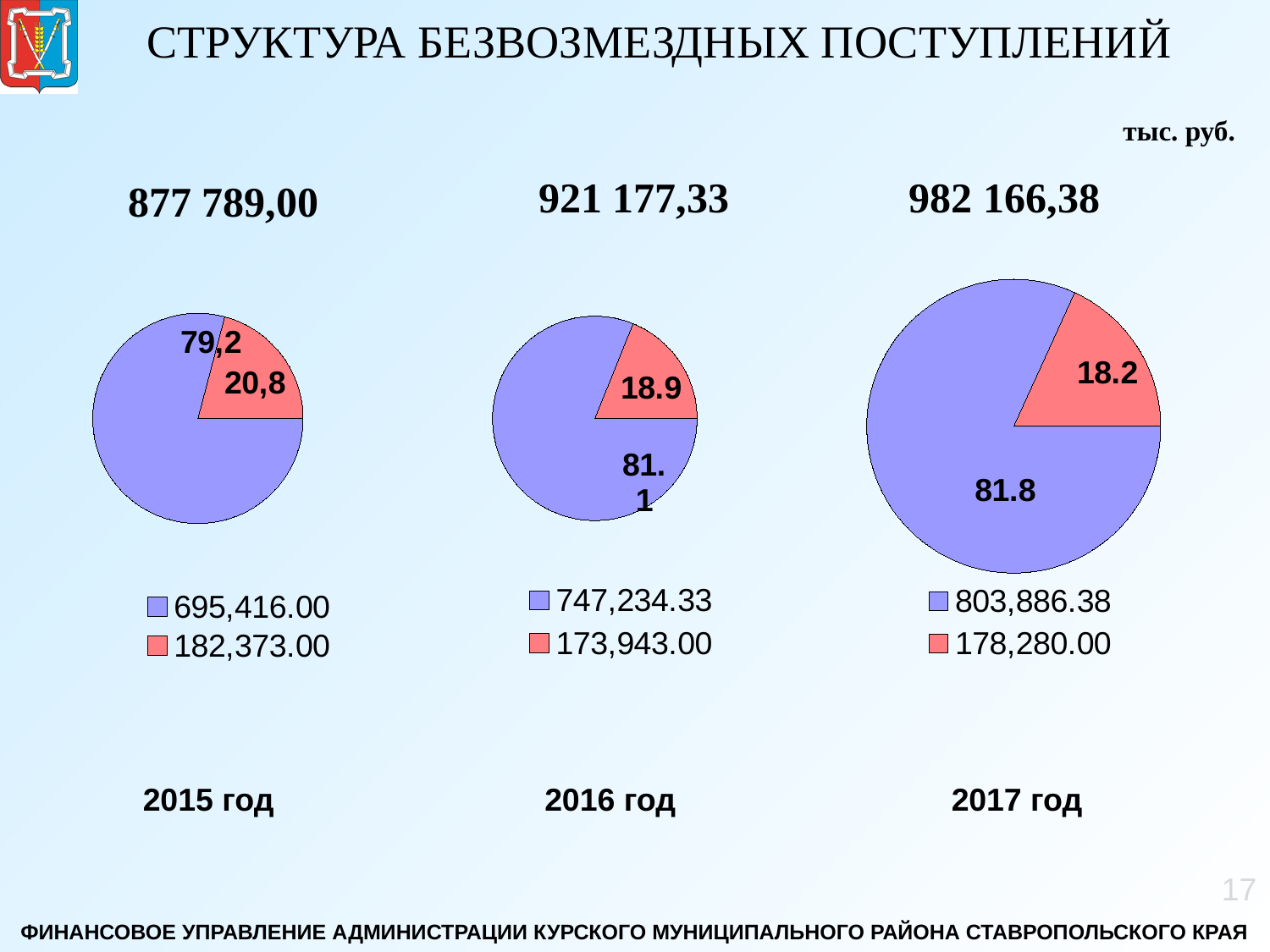
In the 2017 год pie chart, what share does the blue slice have? 81.8 In the 2015 год pie chart, what share does the blue slice have? 79,2 In the 2017 год pie chart, what is the difference between the blue slice's share and the red slice's share? 63.6 In the 2017 год pie chart, what share does the red slice have? 18.2 What kind of chart is used for the 2015 год data? pie chart In the 2016 год pie chart, how many entries does the legend list? 2 In the 2017 год pie chart, how many slices are there? 2 In the 2016 год pie chart, what value does the legend give for the red slice? 173,943.00 In the 2015 год pie chart, which slice is larger, the blue one or the red one? blue